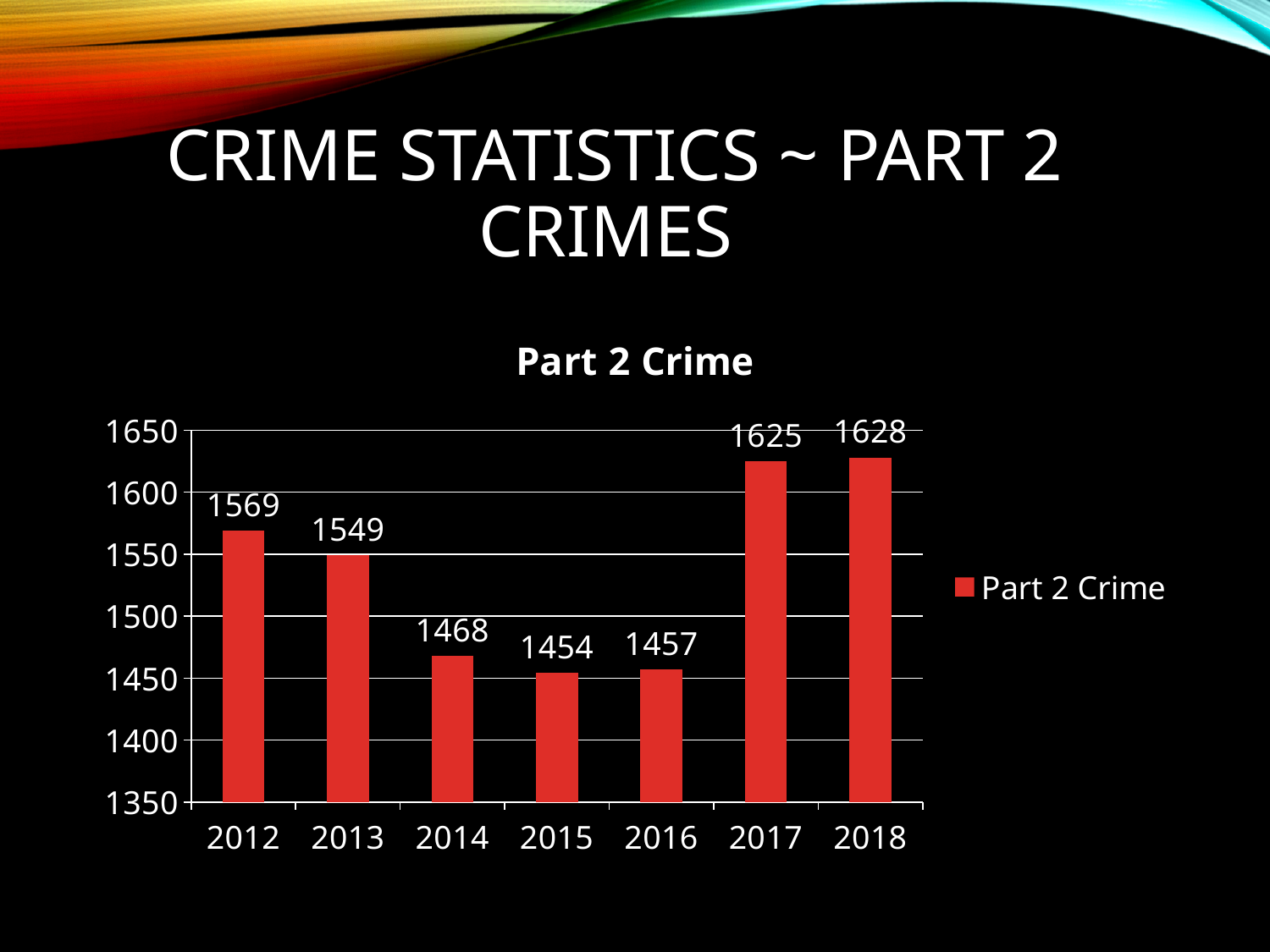
What is the title of the chart? Part 2 Crime What is the Part 2 Crime value for 2018? 1628 What is the Part 2 Crime value for 2012? 1569 Is the Part 2 Crime value for 2014 greater or less than 1500? less What kind of chart is shown on the slide? bar chart How many years are shown on the x axis of the chart? 7 Which year has the lowest Part 2 Crime value? 2015 What is the Part 2 Crime value for 2015? 1454 Which is larger, the Part 2 Crime value for 2013 or for 2016? 2013 What is the difference between the Part 2 Crime values for 2013 and 2014? 81 How many series does the chart legend list? 1 What is the difference between the Part 2 Crime values for 2017 and 2012? 56